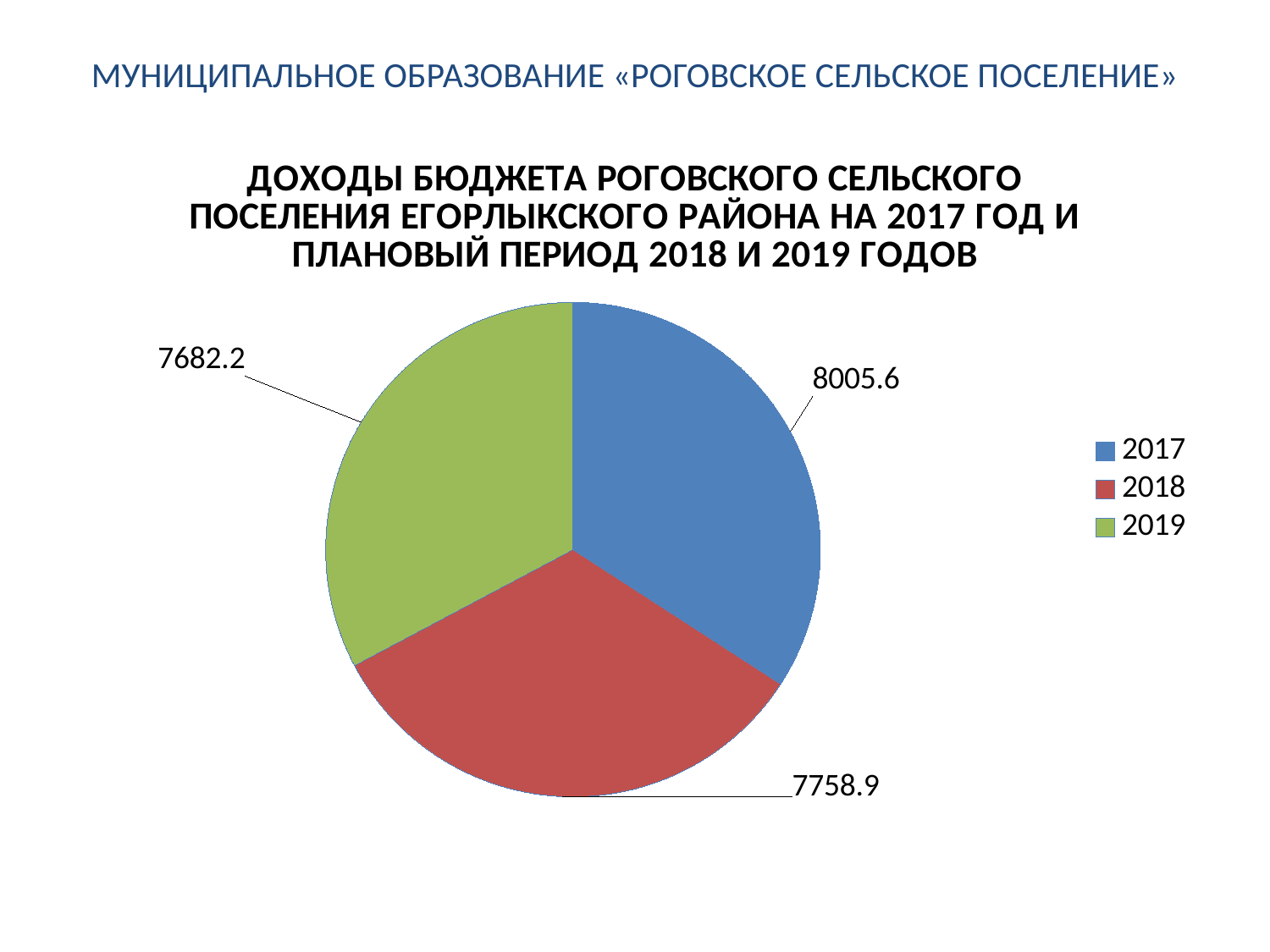
What is the value shown for 2017 on the pie chart? 8005.6 What is the value shown for 2018 on the pie chart? 7758.9 What type of chart is shown on the slide? Pie chart What is the difference between the values for 2017 and 2018? 246.7 Which year has the largest slice of the pie chart? 2017 What colour is the slice for 2018 in the pie chart? Red What is the value shown for 2019 on the pie chart? 7682.2 How many slices does the pie chart have? 3 What is the difference between the values for 2018 and 2019? 76.7 Which is larger, the value for 2017 or the value for 2019? 2017 What is the total of all three values in the pie chart? 23446.7 Which year has the smallest slice of the pie chart? 2019